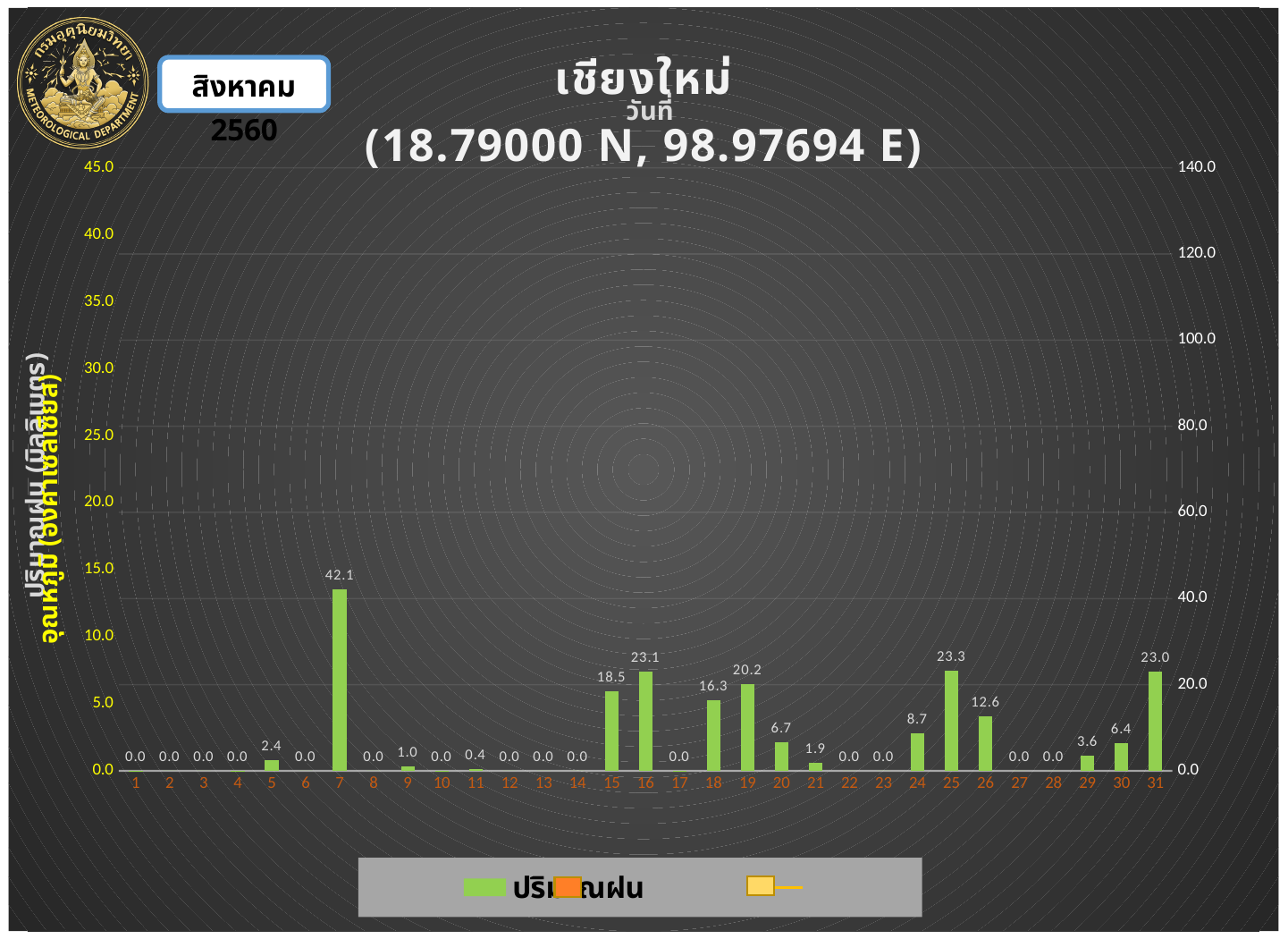
Which day has the highest rainfall value? 7 What is the rainfall value shown for day 7? 42.1 What is the rainfall value shown for day 26? 12.6 What is the rainfall value shown for day 16? 23.1 What is the difference between the rainfall values for day 19 and day 18? 3.9 What kind of chart is shown on the slide? bar chart How many days are shown on the x axis of the chart? 31 What is the difference between the rainfall values for day 7 and day 25? 18.8 What is the rainfall value shown for day 25? 23.3 Which has the larger rainfall value, day 15 or day 18? day 15 Which has the larger rainfall value, day 24 or day 20? day 24 What is the rainfall value shown for day 31? 23.0